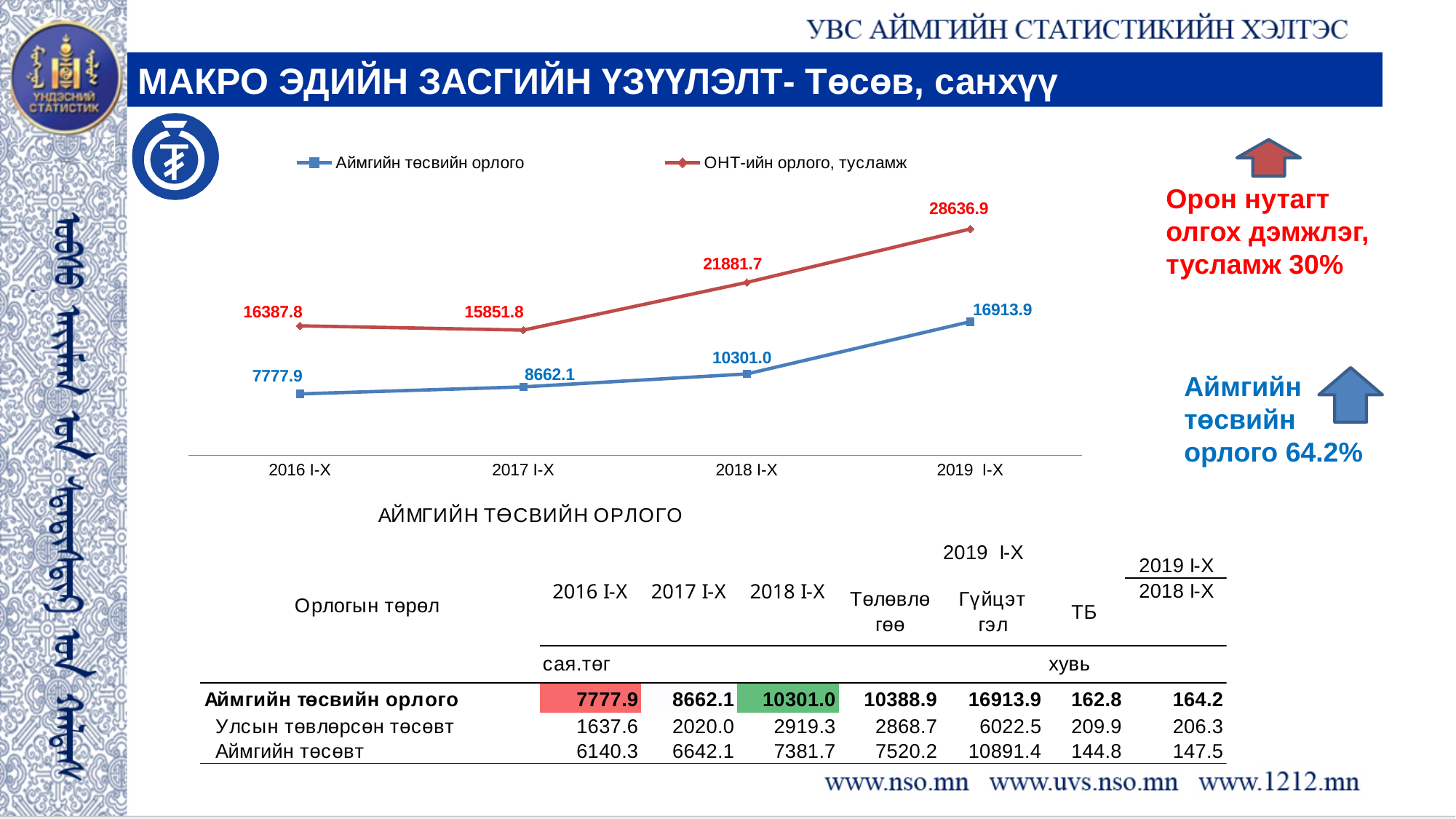
In which period is ОНТ-ийн орлого, тусламж lowest? 2017 I-X What is the value of ОНТ-ийн орлого, тусламж for 2017 I-X? 15851.8 Which series has the larger value in 2019 I-X, Аймгийн төсвийн орлого or ОНТ-ийн орлого, тусламж? ОНТ-ийн орлого, тусламж What is the value of Аймгийн төсвийн орлого for 2016 I-X? 7777.9 What is the difference between ОНТ-ийн орлого, тусламж and Аймгийн төсвийн орлого in 2018 I-X? 11580.7 Does Аймгийн төсвийн орлого rise or fall from 2016 I-X to 2019 I-X? rise What type of chart is shown on the slide? line chart How many time periods are plotted along the x axis of the chart? 4 In which period is Аймгийн төсвийн орлого highest? 2019 I-X What is the value of ОНТ-ийн орлого, тусламж for 2019 I-X? 28636.9 Which colour is used for the ОНТ-ийн орлого, тусламж line? red How many series does the chart legend list? 2